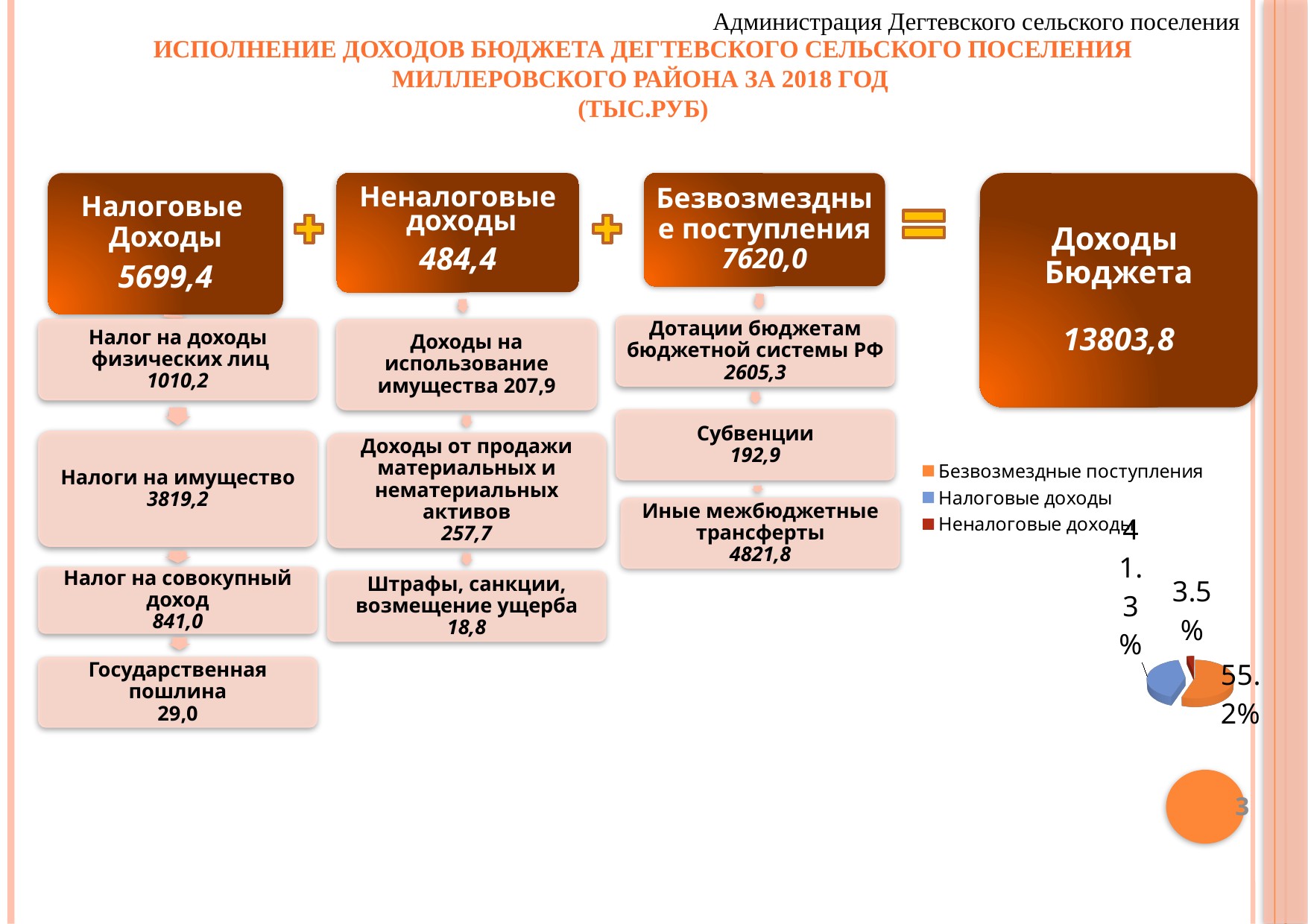
Which colour represents Безвозмездные поступления in the pie chart legend? orange In the pie chart, what share is shown for Безвозмездные поступления? 55.2% In the pie chart, what share is shown for Налоговые доходы? 41.3% In the pie chart, which is larger: Безвозмездные поступления or Налоговые доходы? Безвозмездные поступления How many entries does the legend of the pie chart list? 3 Which category has the smallest slice in the pie chart? Неналоговые доходы How many slices does the pie chart have? 3 What kind of chart is shown in the bottom right of the slide? pie chart In the pie chart, by how many percentage points does Безвозмездные поступления exceed Налоговые доходы? 13.9% Which colour represents Налоговые доходы in the pie chart legend? blue Which category has the largest slice in the pie chart? Безвозмездные поступления In the pie chart, what share is shown for Неналоговые доходы? 3.5%